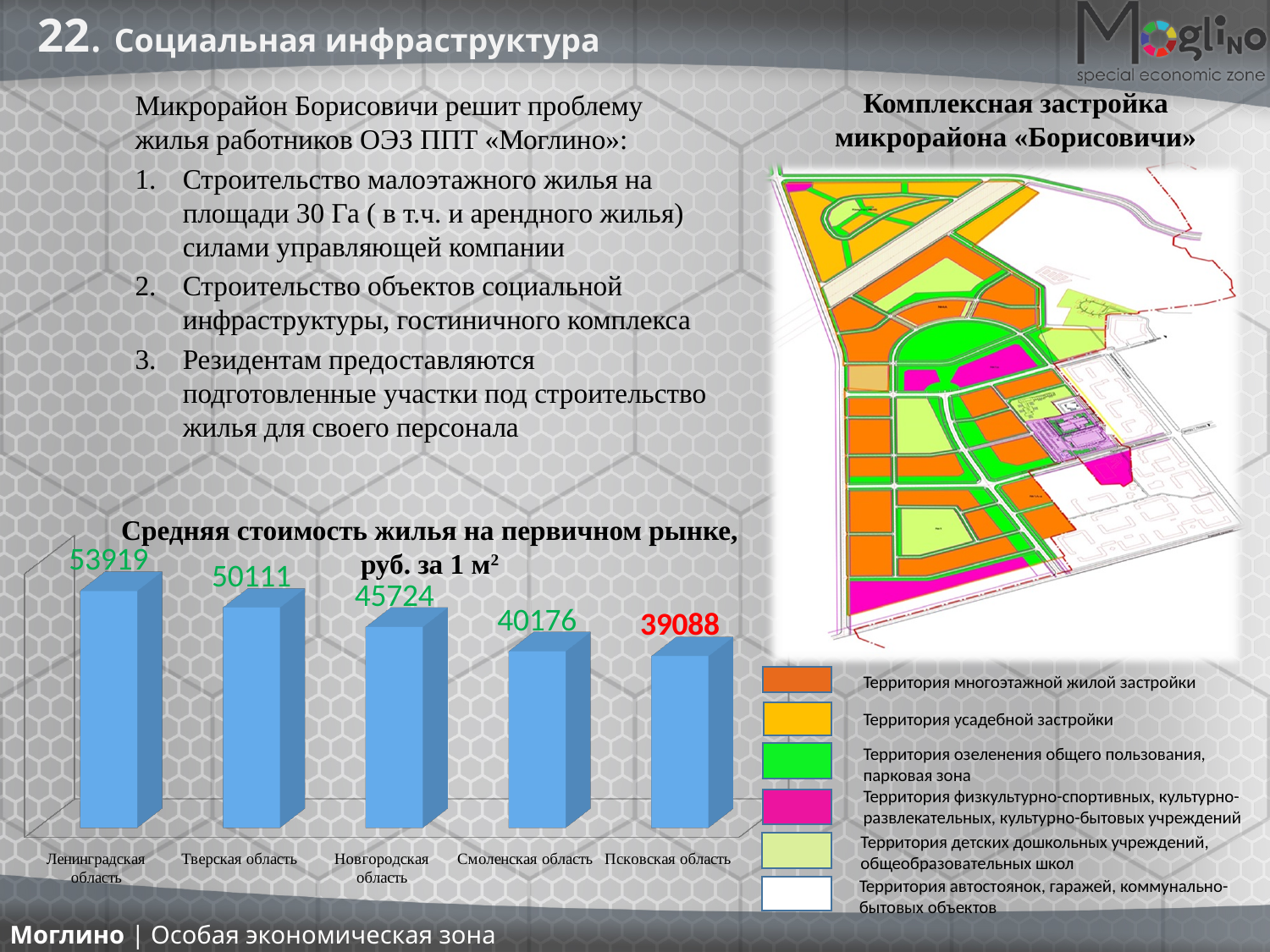
Do the values rise or fall from left to right across the chart? fall What is the average price of housing on the primary market for Ленинградская область? 53919 Which is larger, the value for Новгородская область or the value for Смоленская область? Новгородская область Which region has the highest average housing price in the chart? Ленинградская область What is the difference between the values for Тверская область and Смоленская область? 9935 Which region has the lowest average housing price in the chart? Псковская область What value is shown for Псковская область? 39088 How many regions are shown in the chart? 5 What is the difference between the values for Ленинградская область and Псковская область? 14831 What kind of chart is used to show the average housing prices? bar chart What value is shown for Тверская область? 50111 What value is shown for Новгородская область? 45724